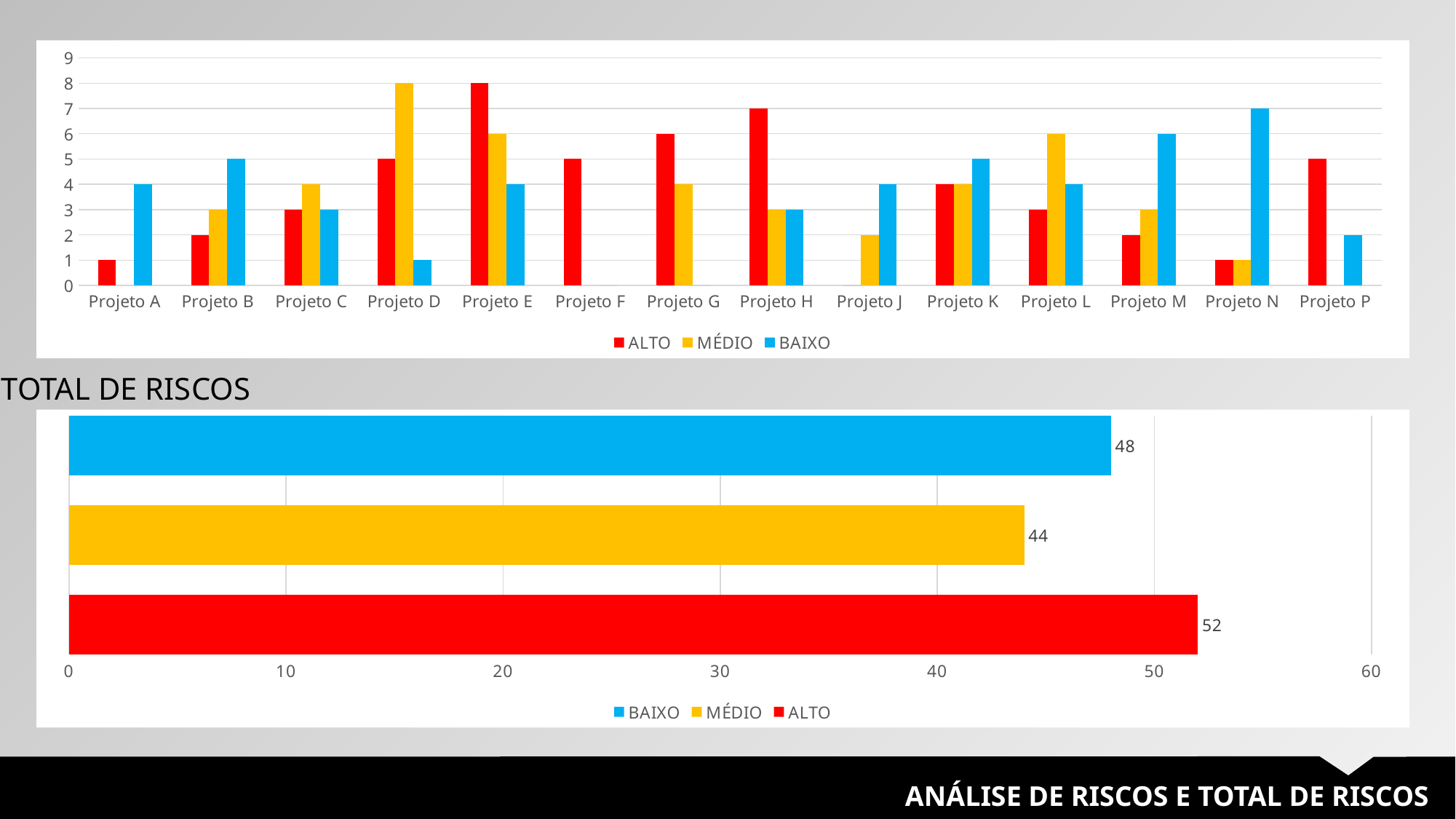
In the top chart, how many series does the legend list? 3 In the TOTAL DE RISCOS chart, what is the value for ALTO? 52 In the top chart, what is the ALTO value for Projeto E? 8 In the top chart, which project has the highest BAIXO value? Projeto N In the top chart, is the ALTO value for Projeto H greater or less than 5? greater In the top chart, which project has the highest ALTO value? Projeto E In the top chart, what is the BAIXO value for Projeto N? 7 In the top chart, what is the MÉDIO value for Projeto D? 8 In the TOTAL DE RISCOS chart, what is the difference between the ALTO and BAIXO values? 4 In the TOTAL DE RISCOS chart, which category has the lowest value? MÉDIO What kind of chart is the TOTAL DE RISCOS chart? Bar chart In the top chart, how many projects are shown on the x axis? 14